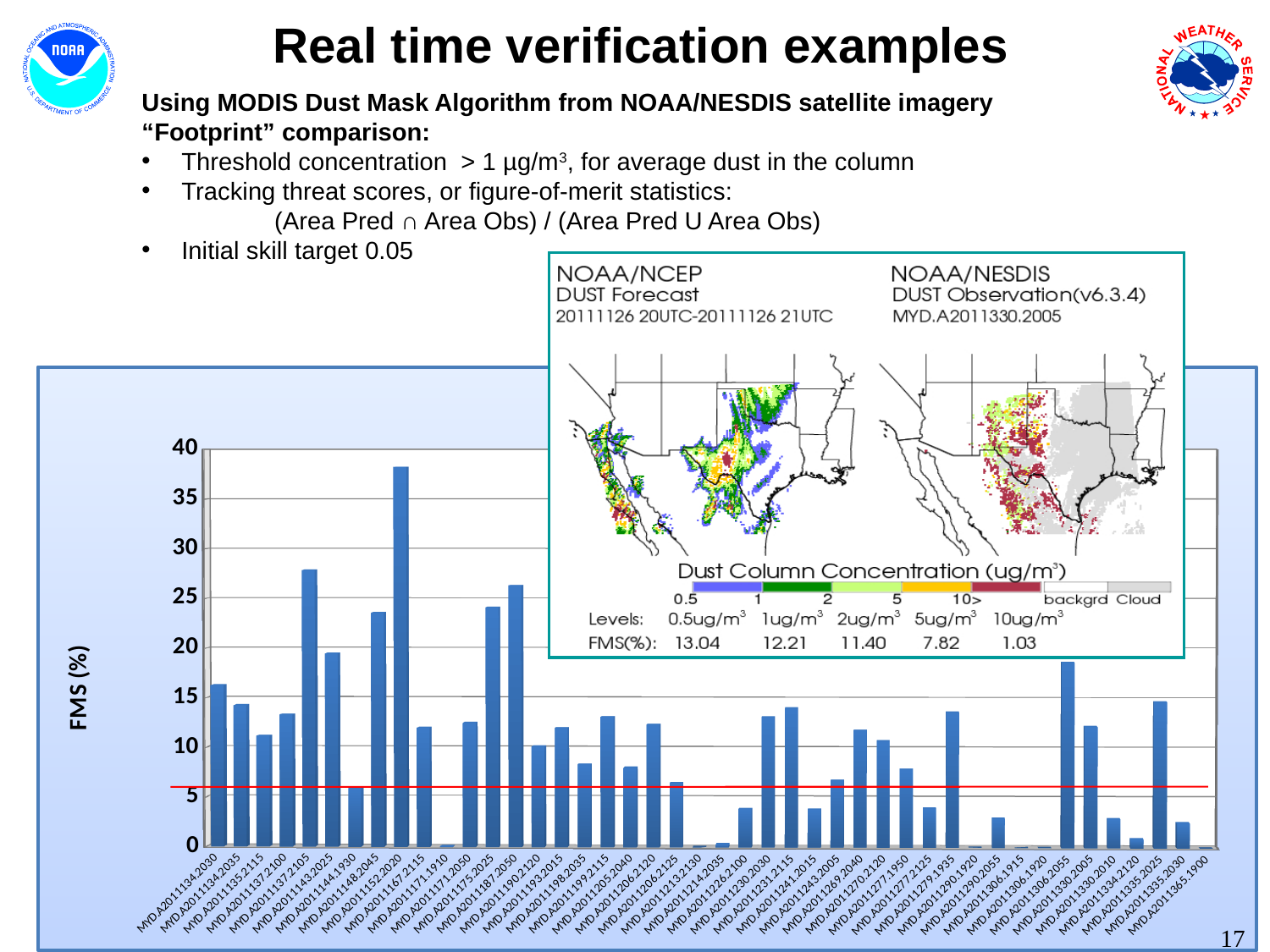
What is the highest value shown on the vertical axis of the bar chart? 40 Which has the larger FMS (%) value, MYD.A2011175.2025 or MYD.A2011190.2120? MYD.A2011175.2025 Is the FMS (%) value for MYD.A2011226.2100 greater or less than 5? less Which has the larger FMS (%) value, MYD.A2011306.2055 or MYD.A2011306.1920? MYD.A2011306.2055 Which category has the highest FMS (%) value in the bar chart? MYD.A2011152.2020 Is the FMS (%) value for MYD.A2011144.1930 greater or less than 10? less Is the FMS (%) value for MYD.A2011152.2020 greater or less than 35? greater Which has the larger FMS (%) value, MYD.A2011152.2020 or MYD.A2011137.2105? MYD.A2011152.2020 What kind of chart is shown on the slide? bar chart What is the label of the vertical axis of the bar chart? FMS (%)